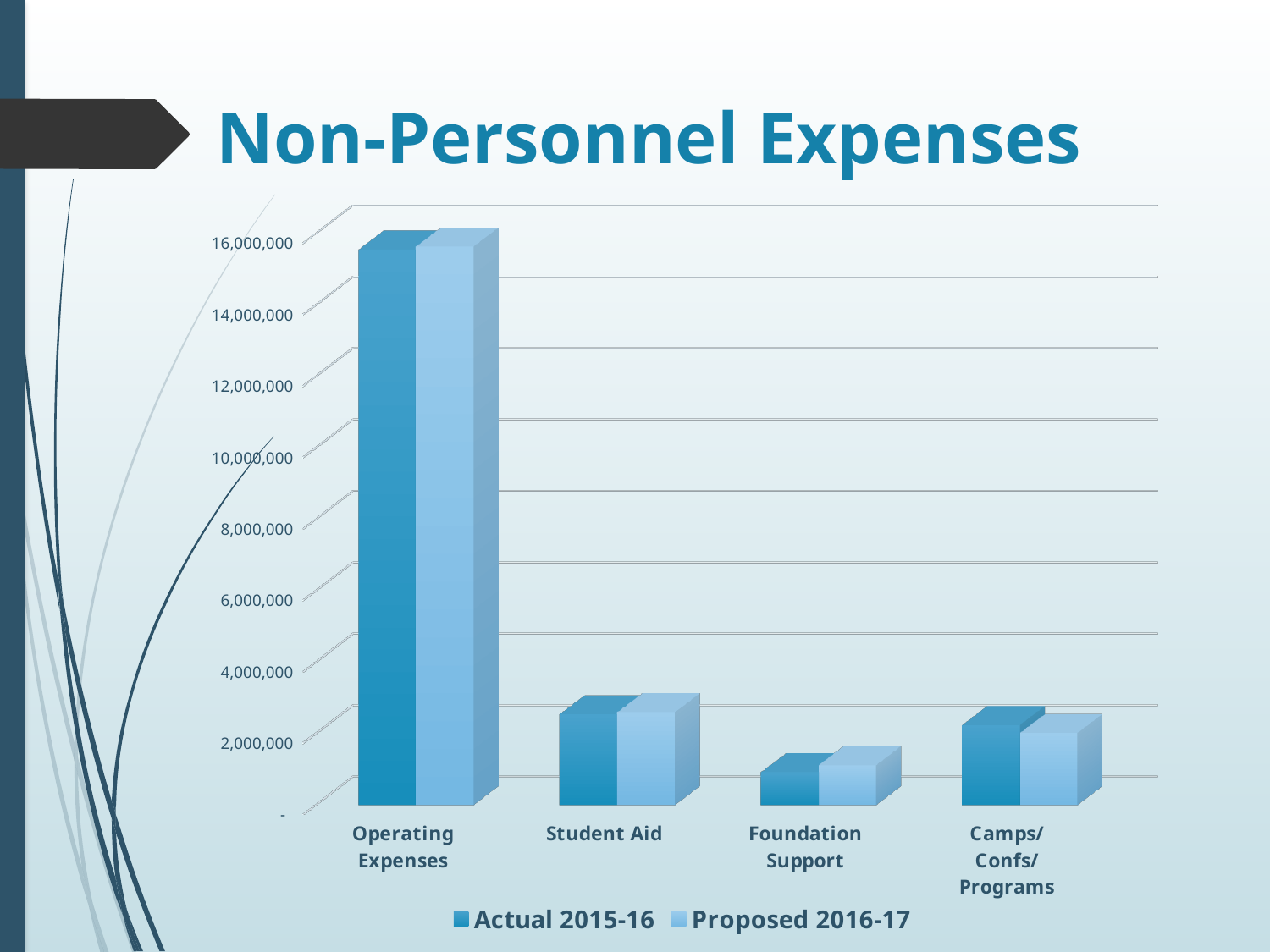
How many categories are shown on the x axis of the chart? 4 Which is larger, the Proposed 2016-17 value for Operating Expenses or the Proposed 2016-17 value for Camps/Confs/Programs? Operating Expenses What is the title of the chart? Non-Personnel Expenses Is the Proposed 2016-17 value for Student Aid greater or less than 4,000,000? less Is the Actual 2015-16 value for Operating Expenses greater or less than 14,000,000? greater Which category has the highest values in the chart? Operating Expenses What kind of chart is shown on the slide? Bar chart How many series does the legend list? 2 Which category has the lowest values in the chart? Foundation Support Which is larger, the Actual 2015-16 value for Student Aid or the Actual 2015-16 value for Foundation Support? Student Aid Is the Actual 2015-16 value for Foundation Support greater or less than 2,000,000? less What are the two series named in the legend? Actual 2015-16 and Proposed 2016-17